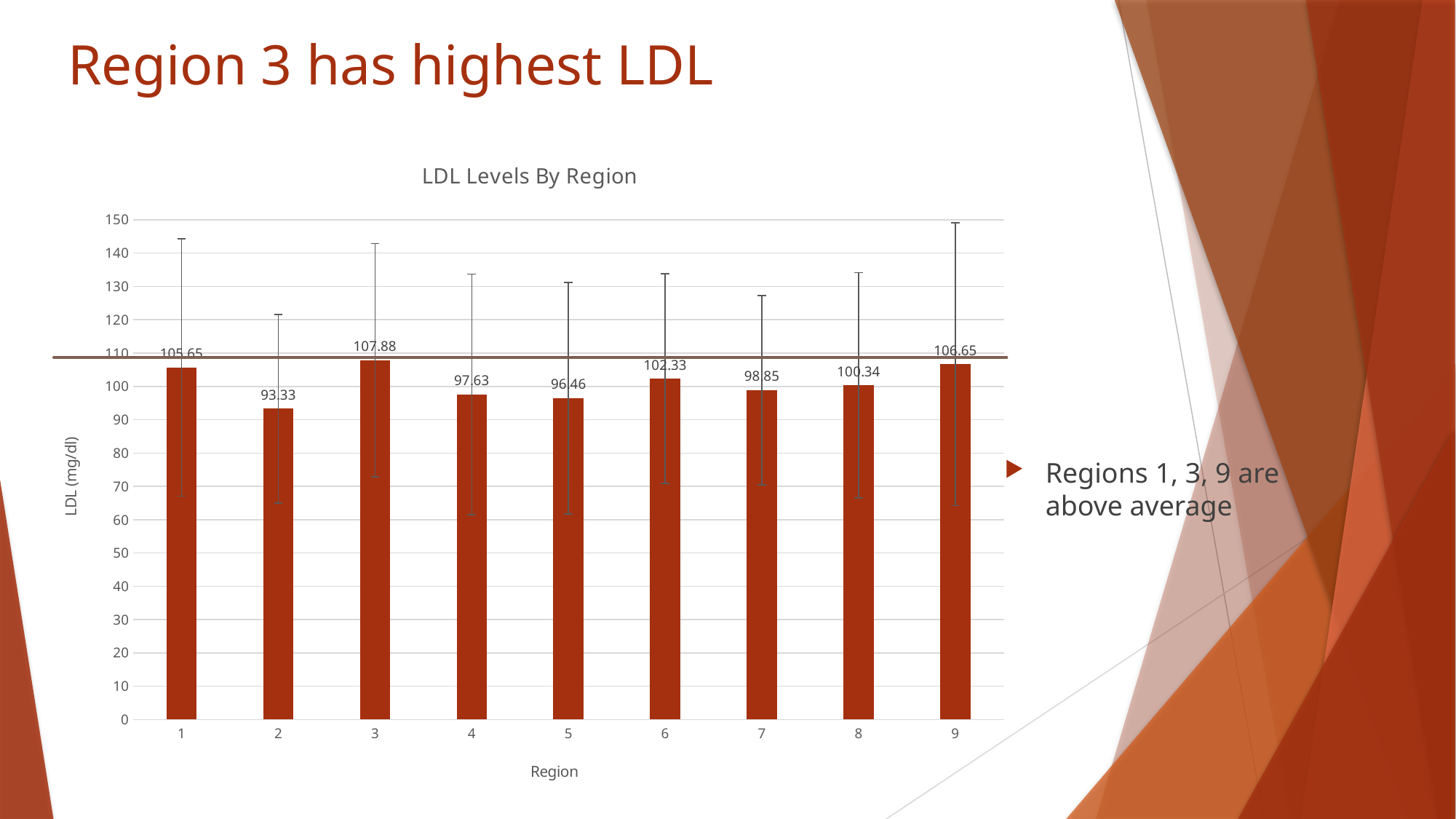
What is the LDL value for region 2? 93.33 Which region has the lowest LDL value? 2 What is the LDL value for region 3? 107.88 How many regions are shown on the x axis? 9 What kind of chart is shown on the slide? Bar chart Which has a larger LDL value, region 4 or region 8? Region 8 What is the title of the chart? LDL Levels By Region Which region has the highest LDL value? 3 What is the label of the y axis? LDL (mg/dl) What is the LDL value for region 6? 102.33 What is the difference between the LDL values for region 3 and region 2? 14.55 Is the LDL value for region 9 greater or less than 100? greater